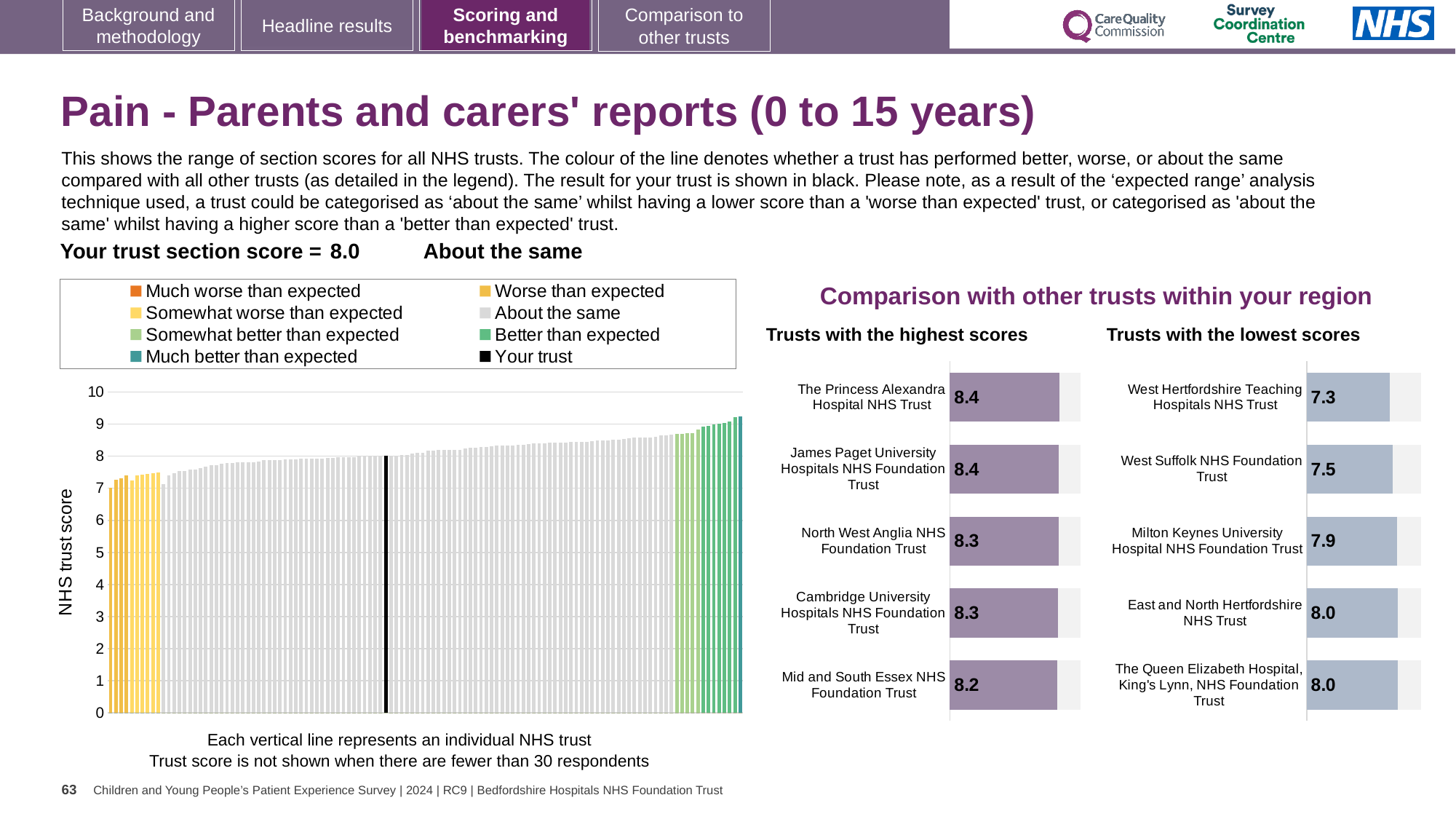
In the 'Trusts with the lowest scores' chart, what is the score for West Hertfordshire Teaching Hospitals NHS Trust? 7.3 In the 'Trusts with the highest scores' chart, what is the difference between the scores of The Princess Alexandra Hospital NHS Trust and Mid and South Essex NHS Foundation Trust? 0.2 In the 'Trusts with the lowest scores' chart, what is the difference between the scores of West Suffolk NHS Foundation Trust and West Hertfordshire Teaching Hospitals NHS Trust? 0.2 How many entries does the legend above the large chart on the left list? 8 In the large chart on the left, what is the score of the black bar representing your trust? 8.0 In the 'Trusts with the lowest scores' chart, which has the higher score: Milton Keynes University Hospital NHS Foundation Trust or West Suffolk NHS Foundation Trust? Milton Keynes University Hospital NHS Foundation Trust In the 'Trusts with the highest scores' chart, what is the score for The Princess Alexandra Hospital NHS Trust? 8.4 In the 'Trusts with the highest scores' chart, what is the score for Mid and South Essex NHS Foundation Trust? 8.2 In the 'Trusts with the lowest scores' chart, which trust has the lowest score? West Hertfordshire Teaching Hospitals NHS Trust How many trusts are listed in the 'Trusts with the highest scores' chart? 5 What kind of chart is the large chart on the left showing NHS trust scores? Bar chart In the large chart on the left, is the value of the tallest bar greater or less than 9? greater